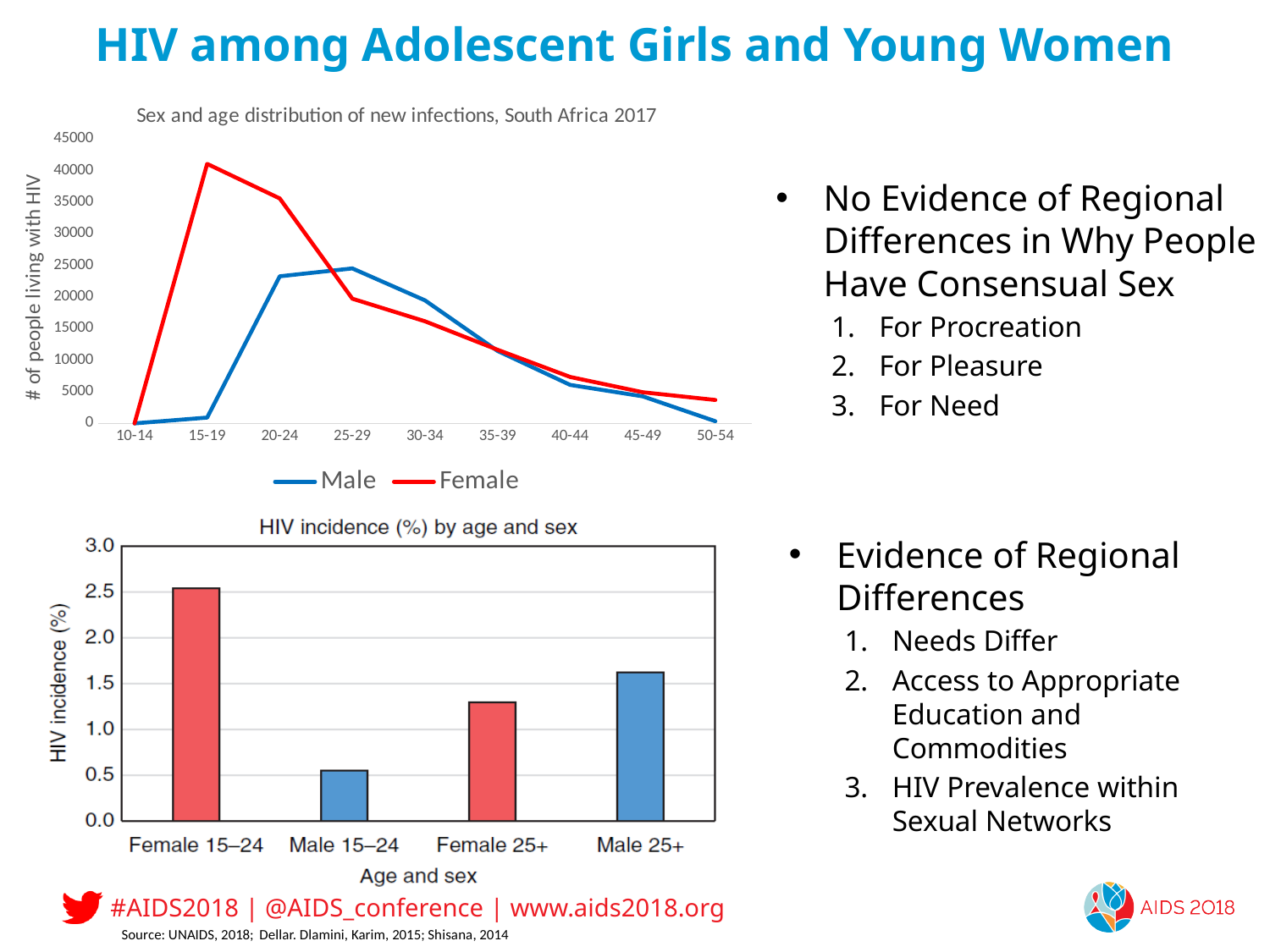
In the bottom chart 'HIV incidence (%) by age and sex', which category has the highest HIV incidence? Female 15–24 In the top chart 'Sex and age distribution of new infections, South Africa 2017', how many age groups are shown on the x axis? 9 In the top chart 'Sex and age distribution of new infections, South Africa 2017', is the Male value for 15-19 greater or less than 5000? less In the top chart 'Sex and age distribution of new infections, South Africa 2017', does the Female line rise or fall from 15-19 to 50-54? fall In the top chart 'Sex and age distribution of new infections, South Africa 2017', which age group has the highest value for Female? 15-19 In the top chart 'Sex and age distribution of new infections, South Africa 2017', which series has the larger value at 25-29, Male or Female? Male In the top chart 'Sex and age distribution of new infections, South Africa 2017', is the Female value for 15-19 greater or less than 35000? greater What kind of chart is the bottom chart 'HIV incidence (%) by age and sex'? bar chart In the top chart 'Sex and age distribution of new infections, South Africa 2017', which age group has the highest value for Male? 25-29 In the bottom chart 'HIV incidence (%) by age and sex', which category has the lowest HIV incidence? Male 15–24 In the top chart 'Sex and age distribution of new infections, South Africa 2017', how many series does the legend list? 2 In the bottom chart 'HIV incidence (%) by age and sex', is the value for Male 15–24 greater or less than 1.0? less